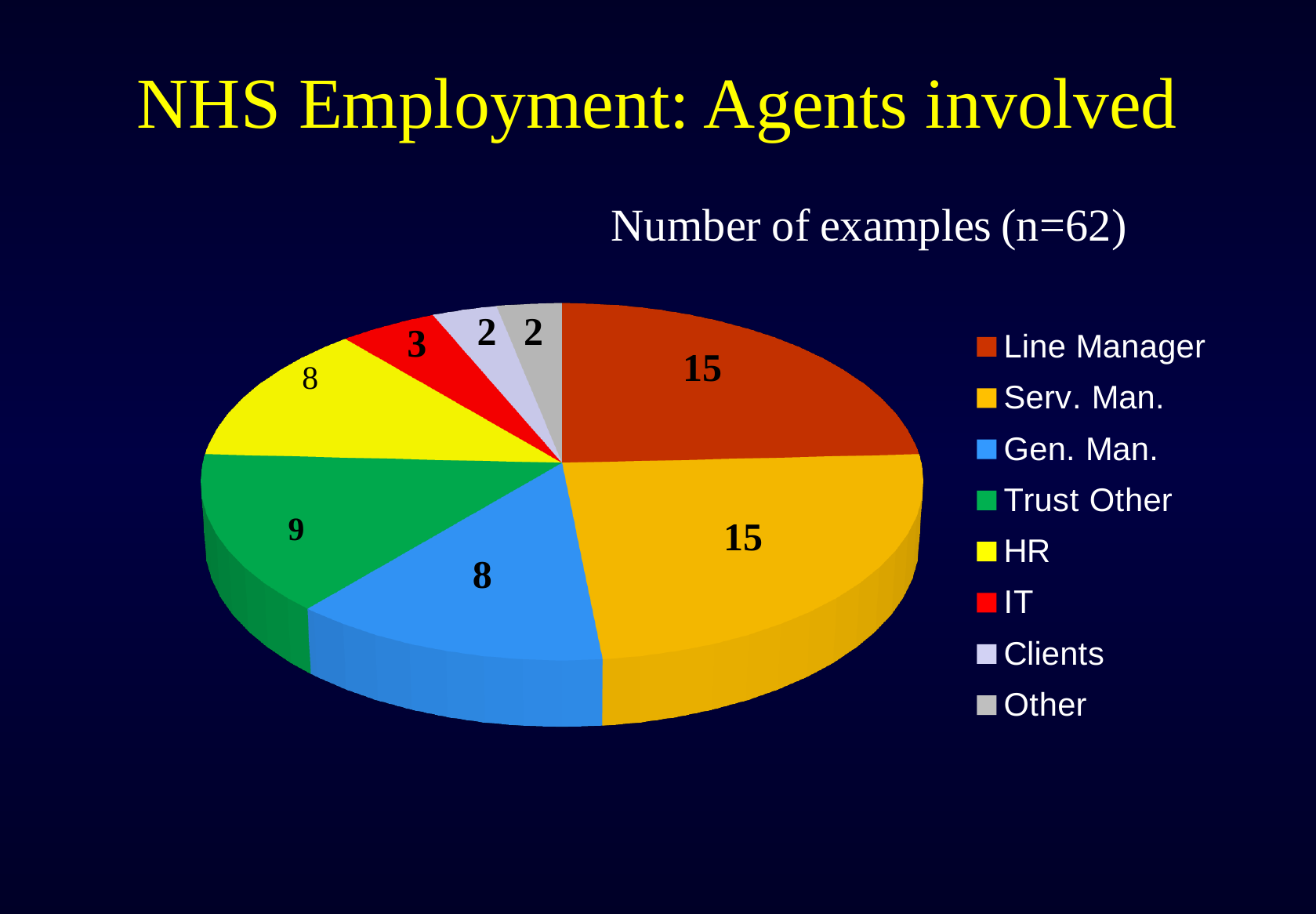
What is the value for Gen. Man.? 8 What is the value for IT? 3 What is the value for Trust Other? 9 What is the value for Clients? 2 Which is larger, IT or Clients? IT What is the difference between the values for Line Manager and IT? 12 How many examples are attributed to Line Manager? 15 What is the title of the slide? NHS Employment: Agents involved How many categories does the pie chart have? 8 What type of chart is shown on the slide? pie chart What is the difference between the values for Serv. Man. and HR? 7 Which is larger, Trust Other or Gen. Man.? Trust Other